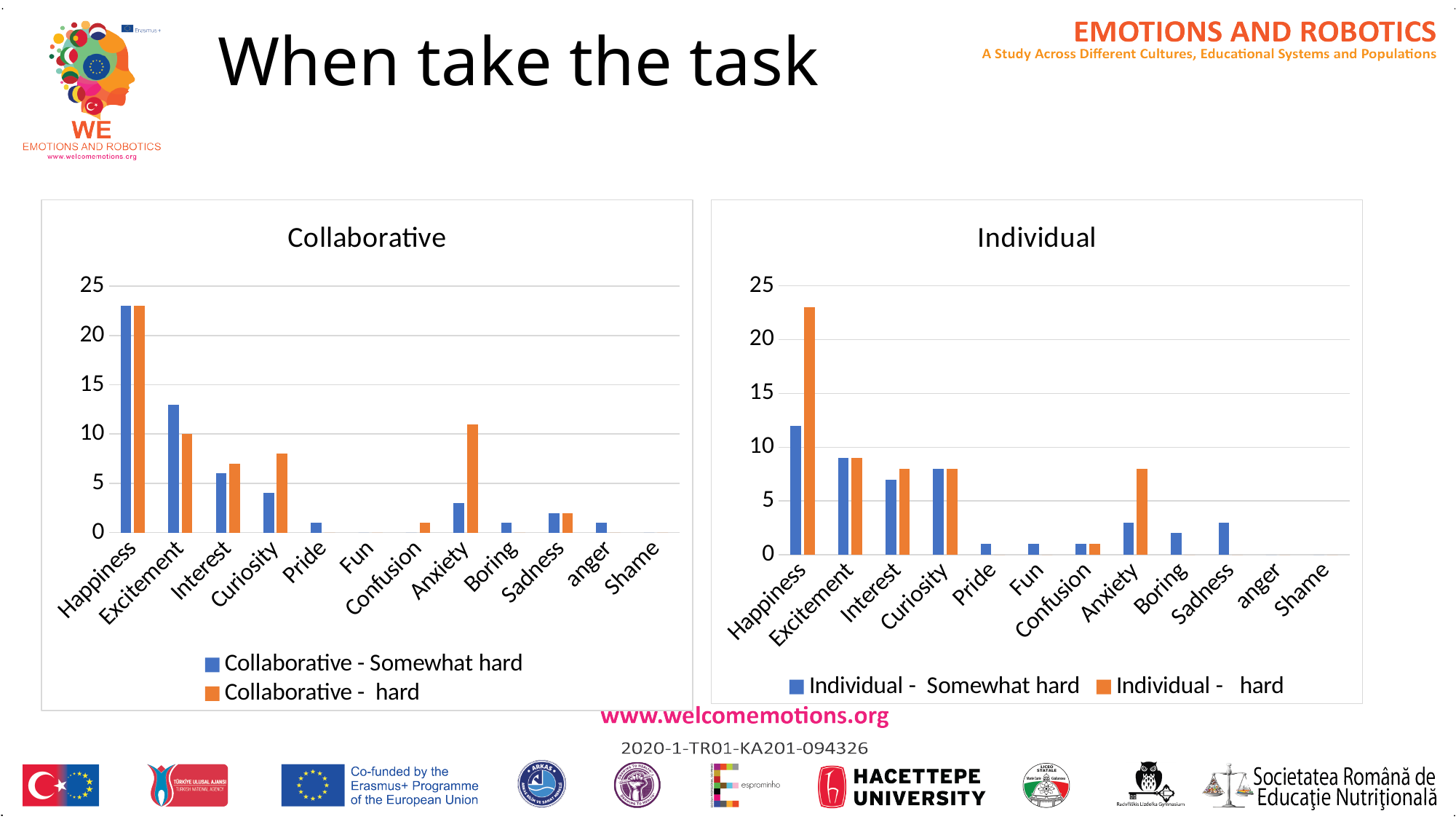
In the Collaborative chart, which is larger for Anxiety: Collaborative - Somewhat hard or Collaborative - hard? Collaborative - hard What colour represents the 'hard' series in both charts? orange How many categories are shown on the x axis of the Collaborative chart? 12 In the Individual chart, is the value for Happiness (Individual - Somewhat hard) greater or less than 15? less In the Individual chart, which is larger for Happiness: Individual - Somewhat hard or Individual - hard? Individual - hard In the Collaborative chart, which category has the highest value for Collaborative - Somewhat hard? Happiness What type of chart is the Collaborative chart? bar chart In the Individual chart, is the value for Anxiety (Individual - hard) greater or less than 5? greater How many series does the legend of the Individual chart list? 2 In the Individual chart, which category has the highest value for Individual - hard? Happiness In the Collaborative chart, is the value for Happiness (Collaborative - hard) greater or less than 20? greater